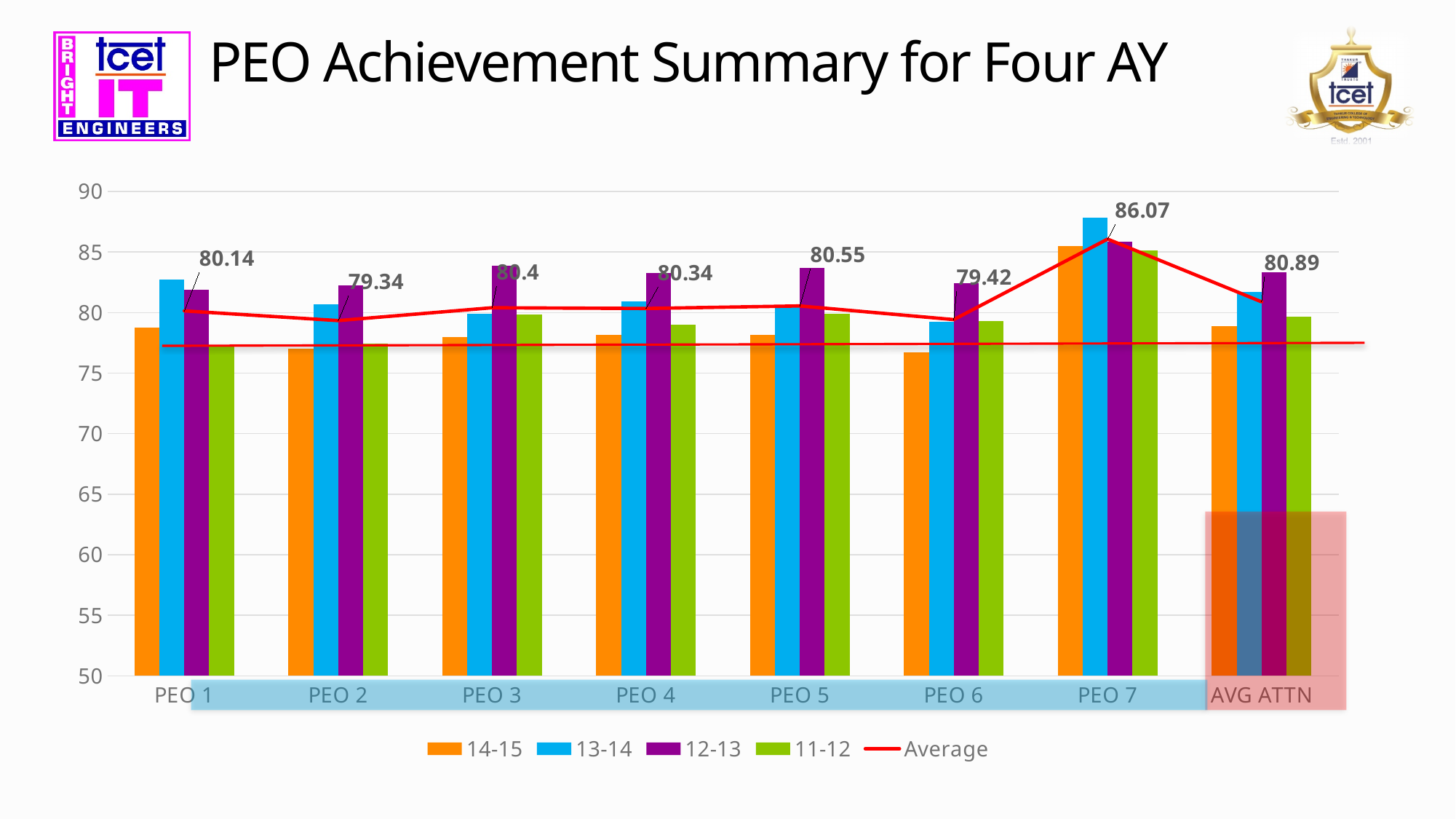
What is the Average value shown for AVG ATTN? 80.89 What kind of chart is used to show the 14-15, 13-14, 12-13 and 11-12 series? Bar chart What is the difference between the Average values for PEO 7 and PEO 1? 5.93 Is the 14-15 value for PEO 6 greater or less than 80? less How many series does the legend list? 5 Which category has the lowest Average value? PEO 2 What is the Average value shown for PEO 7? 86.07 How many categories are shown on the x axis? 8 For PEO 1, which series has the larger value: 13-14 or 14-15? 13-14 Is the 13-14 value for PEO 7 greater or less than 85? greater What is the Average value shown for PEO 1? 80.14 Which category has the highest Average value? PEO 7